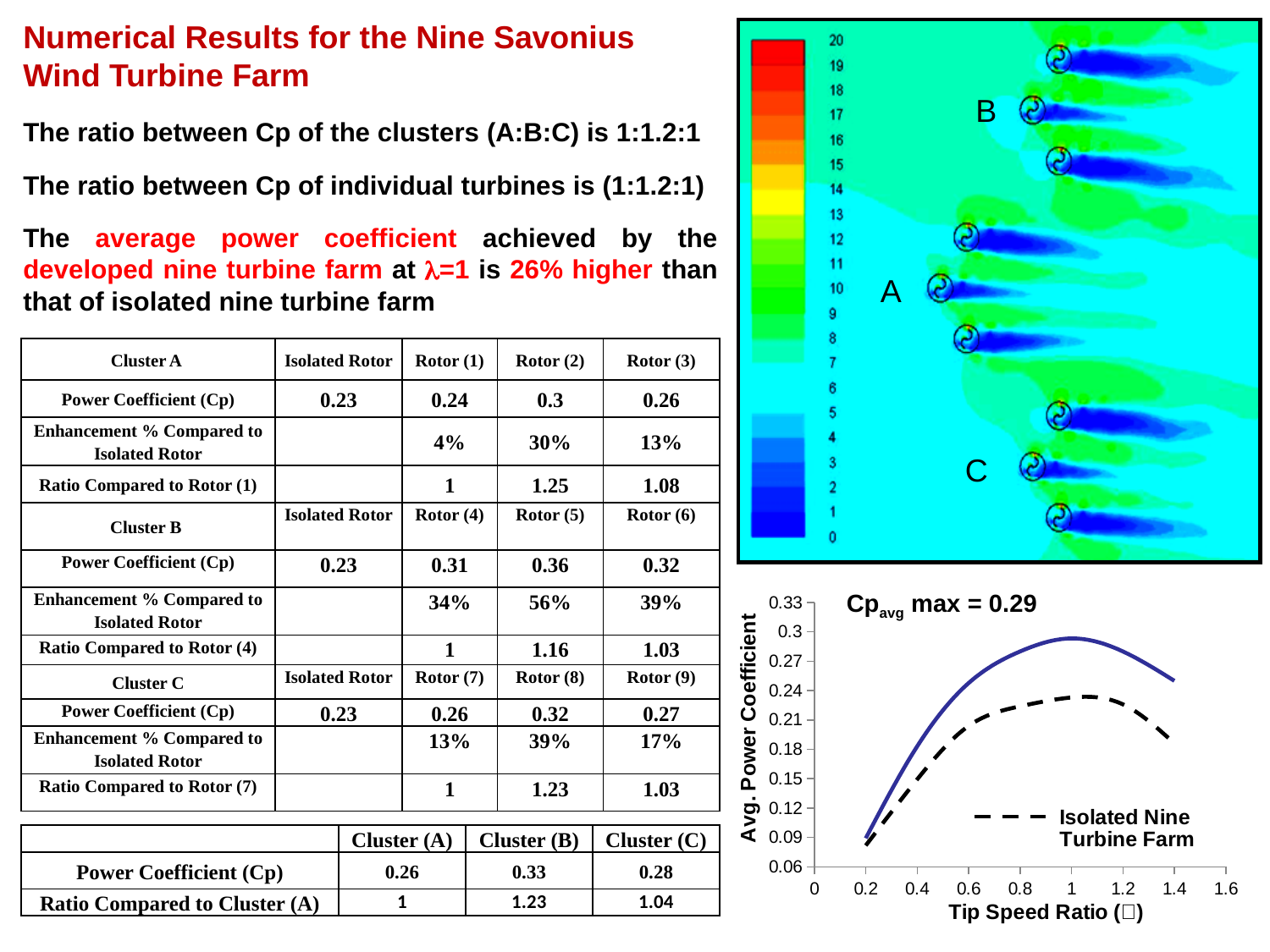
In the bottom-right line chart, is the value of the dashed Isolated Nine Turbine Farm line at a tip speed ratio of 1 greater or less than 0.21? greater In the bottom-right line chart, is the value of the solid line at a tip speed ratio of 0.2 greater or less than 0.12? less In the bottom-right line chart, what is the label of the x axis? Tip Speed Ratio In the bottom-right line chart, what is the label of the y axis? Avg. Power Coefficient In the bottom-right line chart, is the value of the solid line at a tip speed ratio of 1 greater or less than 0.27? greater In the bottom-right line chart, do the values of the solid line rise or fall as the tip speed ratio increases from 0.2 to 1? rise What kind of chart is shown at the bottom right of the slide? line chart In the bottom-right line chart, do the values of the dashed line rise or fall as the tip speed ratio increases from 1 to 1.4? fall In the bottom-right line chart, how many lines are plotted? 2 In the bottom-right line chart, what maximum value of Cp avg is annotated on the chart? 0.29 In the bottom-right line chart, at a tip speed ratio of 1, which line is higher: the solid line or the dashed Isolated Nine Turbine Farm line? the solid line